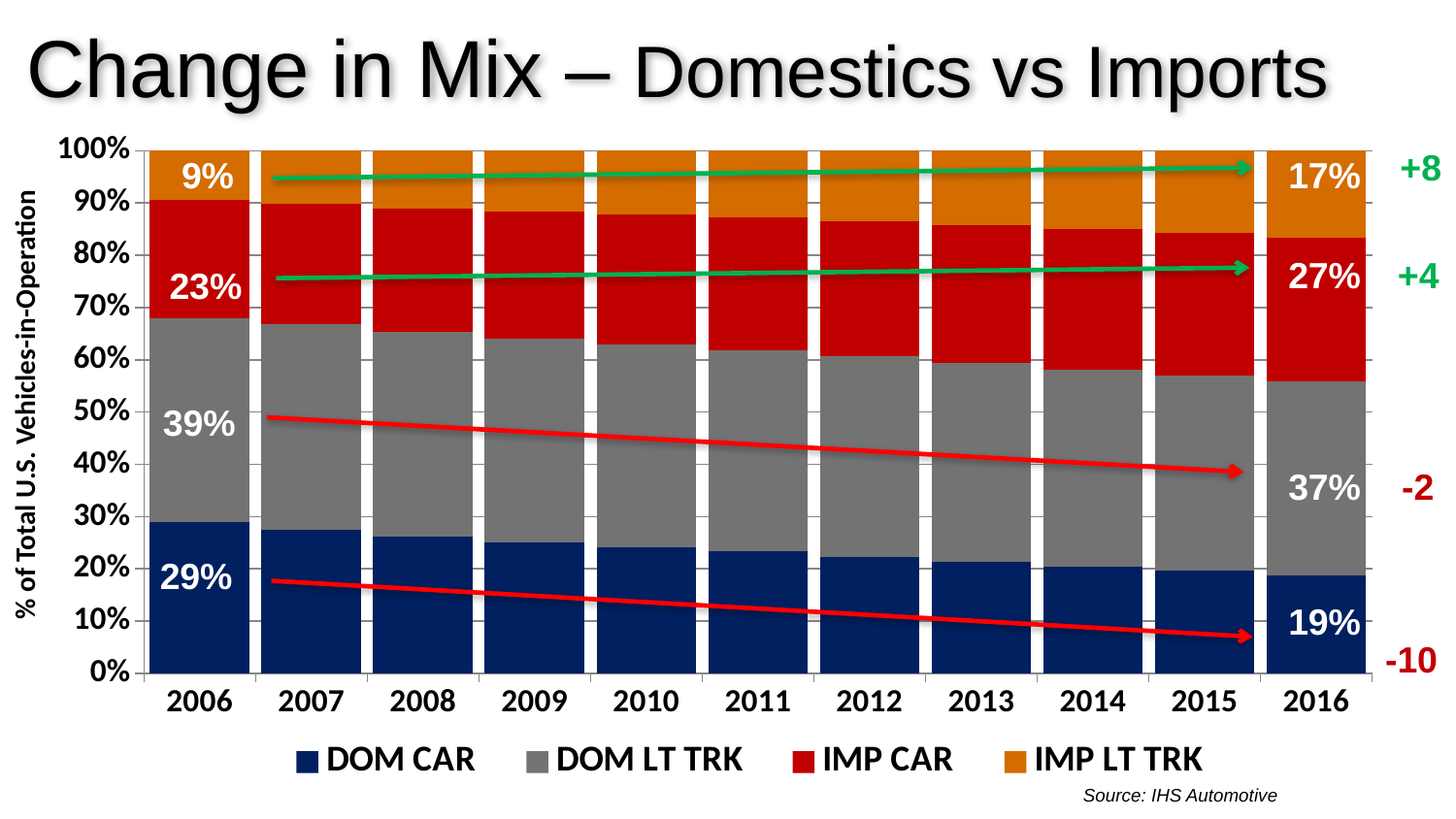
How many series does the legend list? 4 Does the DOM CAR share rise or fall from 2006 to 2016? Fall What is the IMP LT TRK share in 2016? 17% Which year has the larger IMP CAR share, 2006 or 2016? 2016 By how many percentage points did the DOM CAR share change from 2006 to 2016? -10 Is the DOM CAR share in 2010 greater or less than 30%? less What is the label on the y axis? % of Total U.S. Vehicles-in-Operation Which series has the largest share in 2006? DOM LT TRK What is the DOM LT TRK share in 2016? 37% What percentage of total U.S. vehicles-in-operation were DOM CAR in 2006? 29% What kind of chart is shown on the slide? Stacked bar chart How many years are shown on the x axis? 11